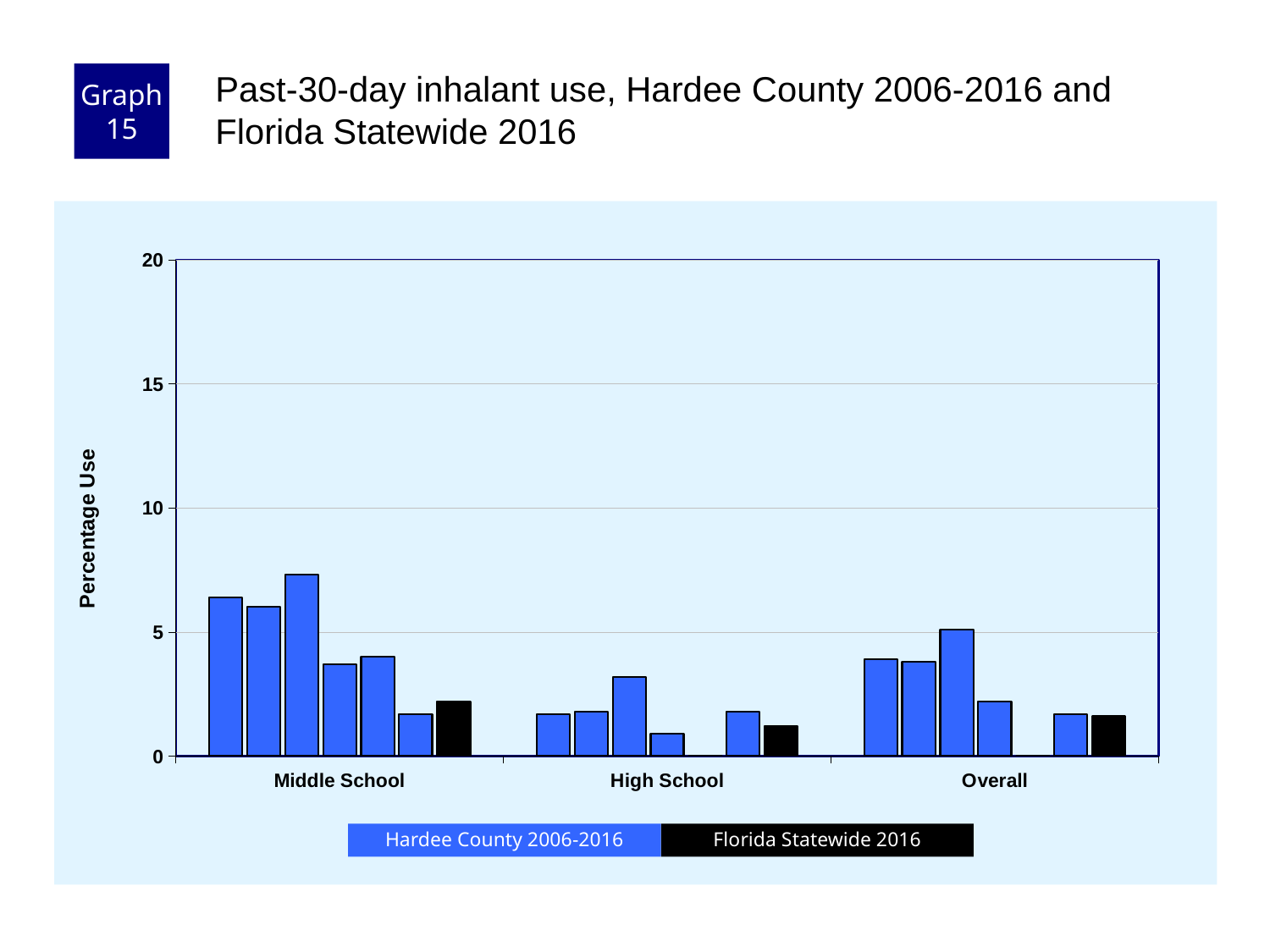
What is the y-axis title? Percentage Use In the Overall group, is the Florida Statewide 2016 bar taller or shorter than the tallest Hardee County 2006-2016 bar? shorter Is the Florida Statewide 2016 value for Middle School greater or less than 5? less Is the highest value plotted anywhere on the chart greater or less than 10? less Is the Florida Statewide 2016 value larger for Middle School or for High School? Middle School Which category has the highest Florida Statewide 2016 value? Middle School How many categories are shown on the x axis? 3 How many series does the legend list? 2 Which category has the lowest Florida Statewide 2016 value? High School What are the three categories on the x axis? Middle School, High School, Overall Is the tallest Hardee County 2006-2016 bar in the Middle School group greater or less than 5? greater What kind of chart is shown on the slide? bar chart